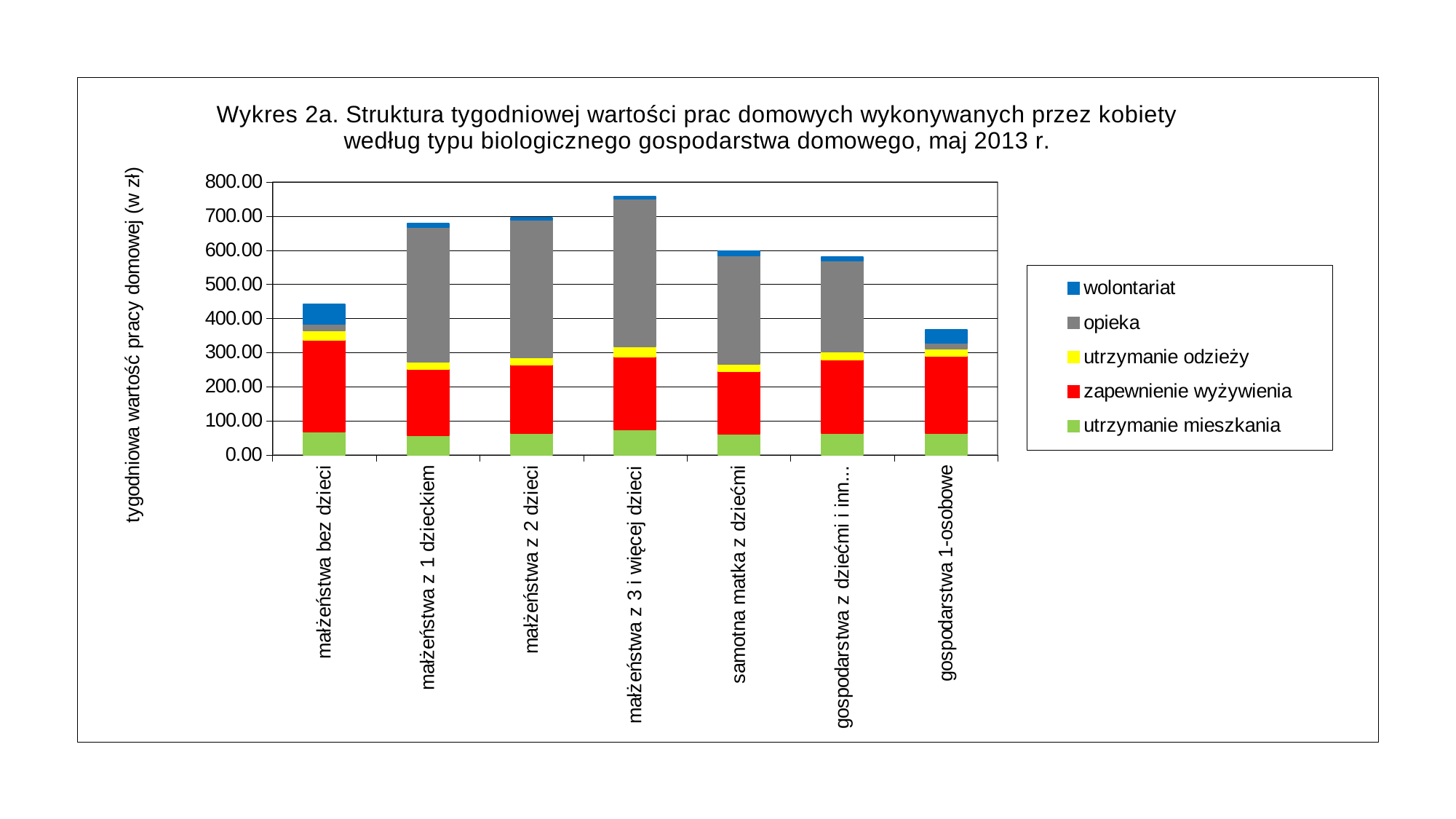
How many series does the legend list? 5 What kind of chart is shown on the slide? stacked bar chart Is the total value for małżeństwa z 3 i więcej dzieci greater or less than 700.00? greater Which has a larger total: małżeństwa z 2 dzieci or samotna matka z dziećmi? małżeństwa z 2 dzieci Which household type has the highest total weekly value of housework? małżeństwa z 3 i więcej dzieci Is the total value for małżeństwa bez dzieci greater or less than 400.00? greater Which colour represents the series 'opieka' in the legend? grey How many household types (categories) are shown on the x axis? 7 Is the total value for gospodarstwa 1-osobowe greater or less than 400.00? less Which household type has the lowest total weekly value of housework? gospodarstwa 1-osobowe What is the label of the y axis? tygodniowa wartość pracy domowej (w zł)